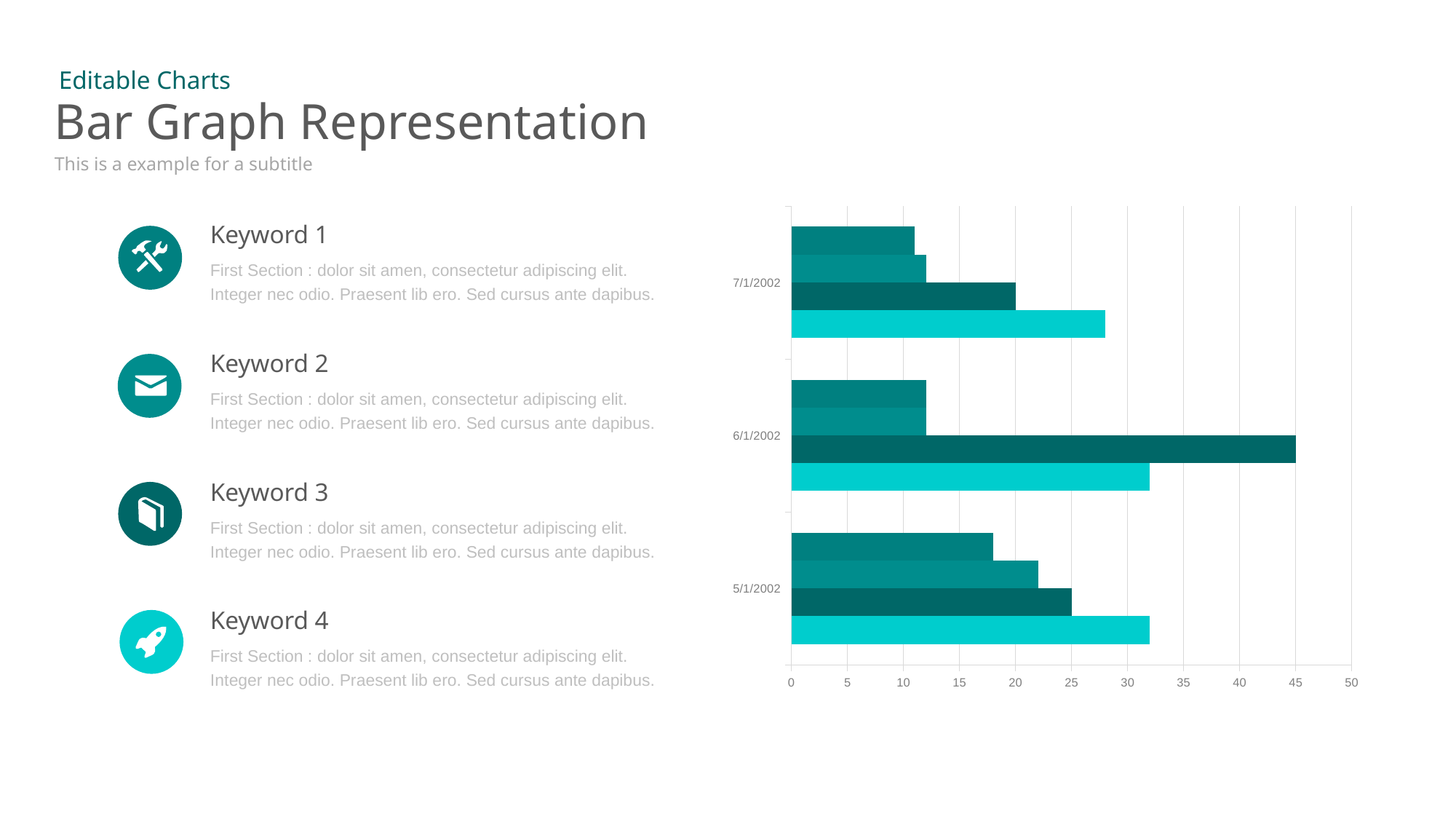
Is the longest bar for 6/1/2002 greater or less than 40? greater What value does the longest bar for 6/1/2002 reach on the horizontal axis? 45 How many date categories are shown on the chart's vertical axis? 3 Which is larger: the longest bar for 6/1/2002 or the longest bar for 7/1/2002? 6/1/2002 What is the maximum value shown on the chart's horizontal axis? 50 Is the longest bar for 7/1/2002 greater or less than 30? less What kind of chart is shown on the slide? bar chart Is the shortest bar for 7/1/2002 greater or less than 15? less Which date category contains the longest bar on the chart? 6/1/2002 What is the interval between tick marks on the chart's horizontal axis? 5